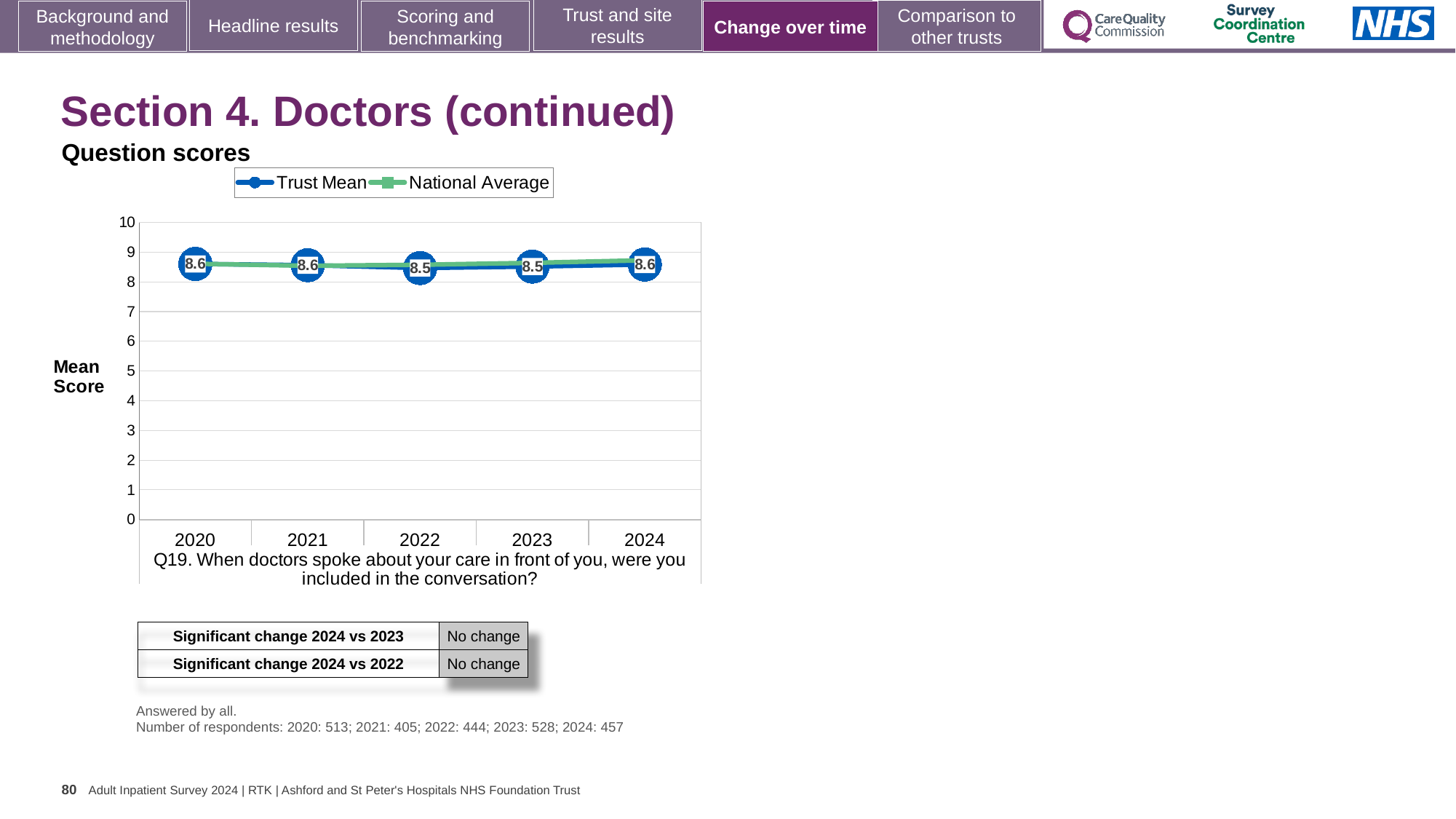
What is the Trust Mean score for 2024? 8.6 What is the difference between the Trust Mean score in 2020 and in 2022? 0.1 What is the Trust Mean score for 2023? 8.5 How many series does the chart legend list? 2 Which year has the larger Trust Mean score, 2021 or 2023? 2021 What is the Trust Mean score for 2022? 8.5 Does the Trust Mean rise or fall from 2022 to 2024? rise Is the National Average value for 2024 greater or less than 8? greater What is the Trust Mean score for 2020? 8.6 What are the two series named in the chart legend? Trust Mean and National Average How many years are plotted on the x axis of the chart? 5 What kind of chart is shown on the slide? line chart